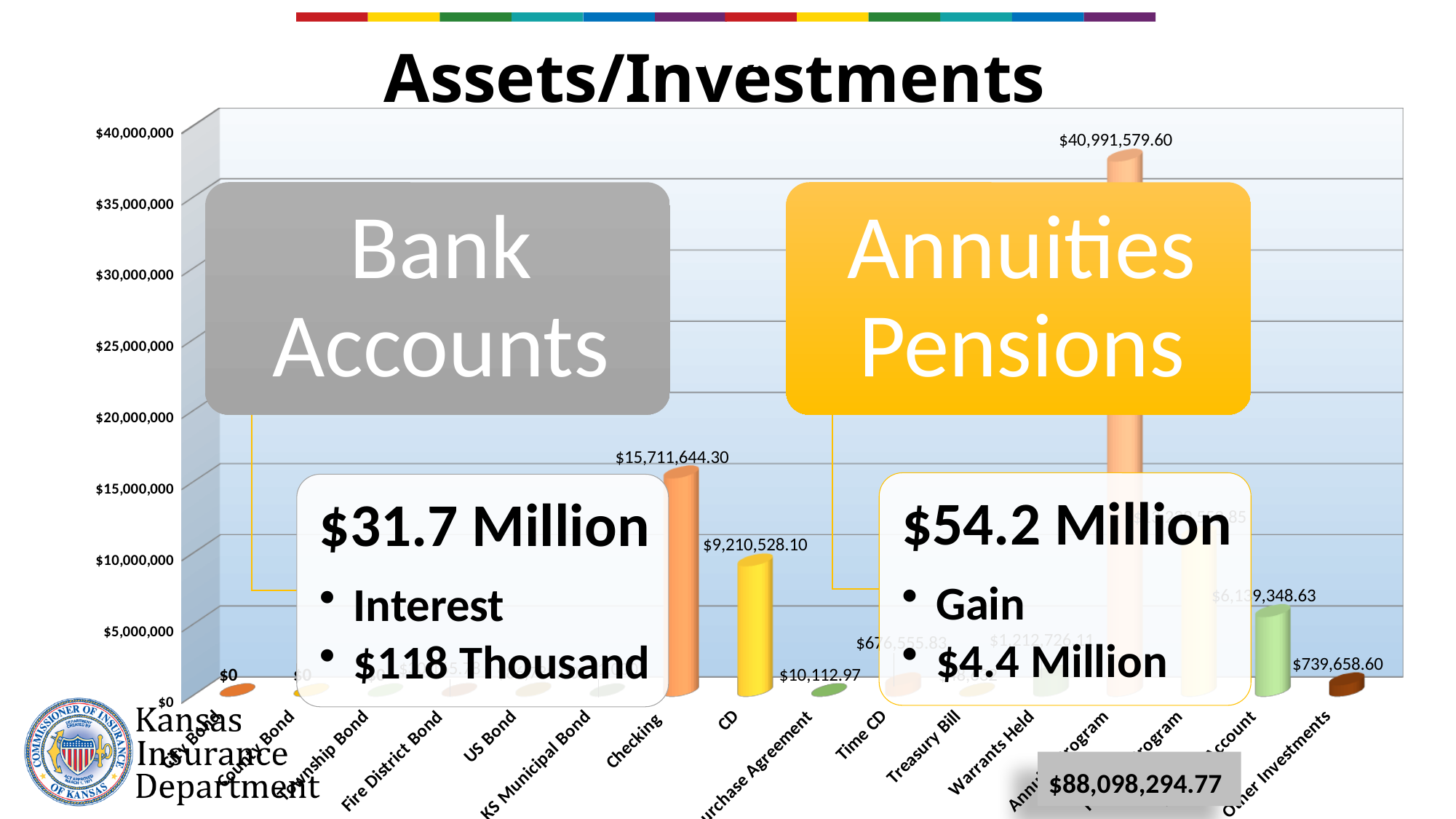
What is the value for Checking? $15,711,644.30 What total amount is shown in the grey box at the bottom right of the chart? $88,098,294.77 What type of chart is shown on the slide? bar chart What is the difference between the value for Checking and the value for Other Investments? $14,971,985.70 Which is larger, the value for CD or the value for Other Investments? CD Which is larger, the value for Checking or the value for CD? Checking What is the value for Other Investments? $739,658.60 What is the difference between the value for Checking and the value for CD? $6,501,116.20 What is the title of the chart? Assets/Investments What is the value for CD? $9,210,528.10 What is the value of the tallest bar in the chart? $40,991,579.60 Is the value for CD greater or less than $10,000,000? less